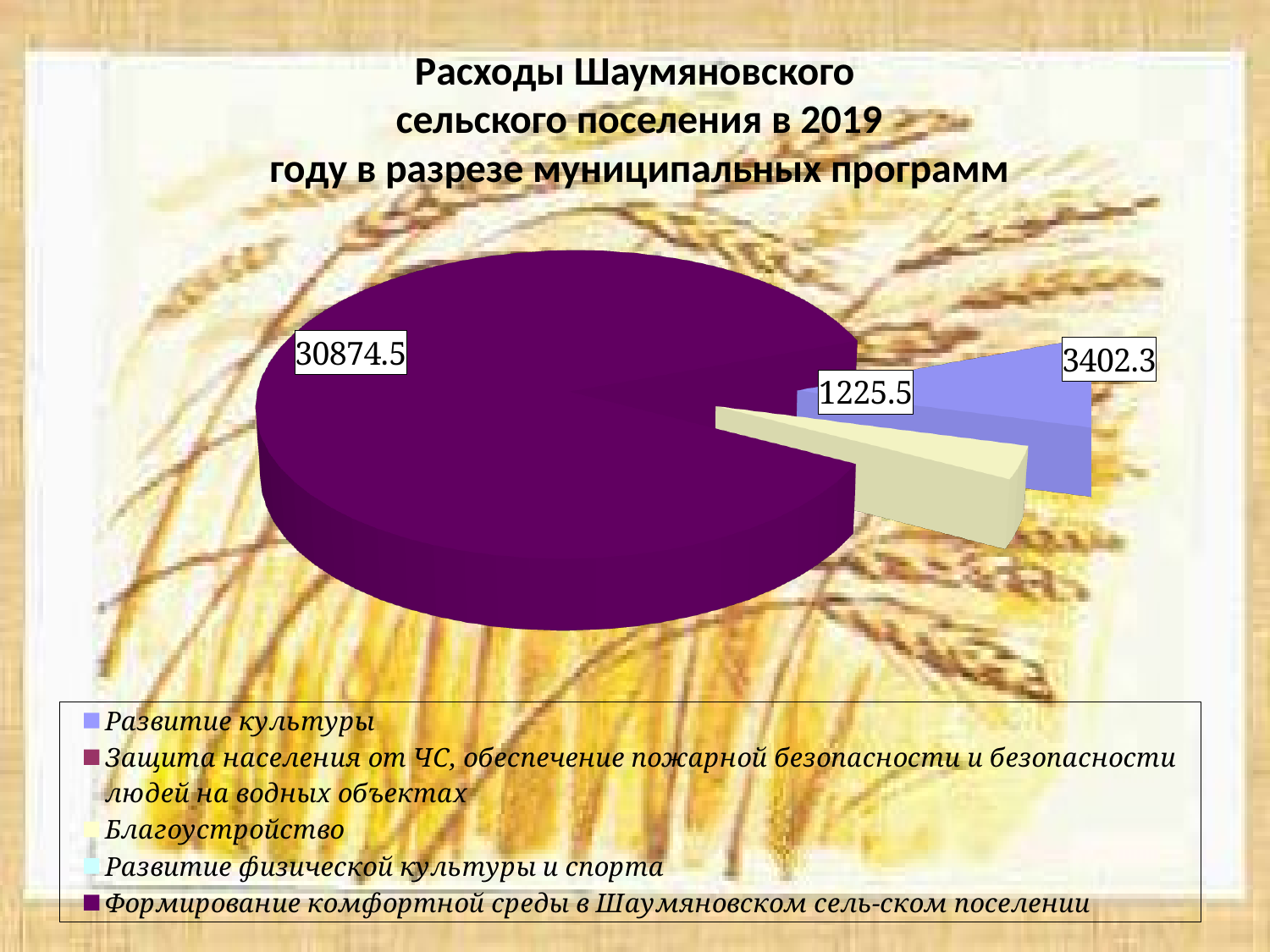
What is the difference between the Формирование комфортной среды value and the Развитие культуры value? 27472.2 Which of the labelled slices has the smallest value? Благоустройство What value is shown for the Развитие культуры slice? 3402.3 How many entries does the legend list? 5 What colour is the slice for Развитие культуры? Light blue How many slices have data labels printed on the pie? 3 What kind of chart is shown on the slide? Pie chart What value is shown for the Формирование комфортной среды в Шаумяновском сельском поселении slice? 30874.5 Which program has the largest slice of the pie? Формирование комфортной среды в Шаумяновском сельском поселении What value is shown for the Благоустройство slice? 1225.5 Which is larger, the Развитие культуры slice or the Благоустройство slice? Развитие культуры What is the difference between the Развитие культуры value and the Благоустройство value? 2176.8